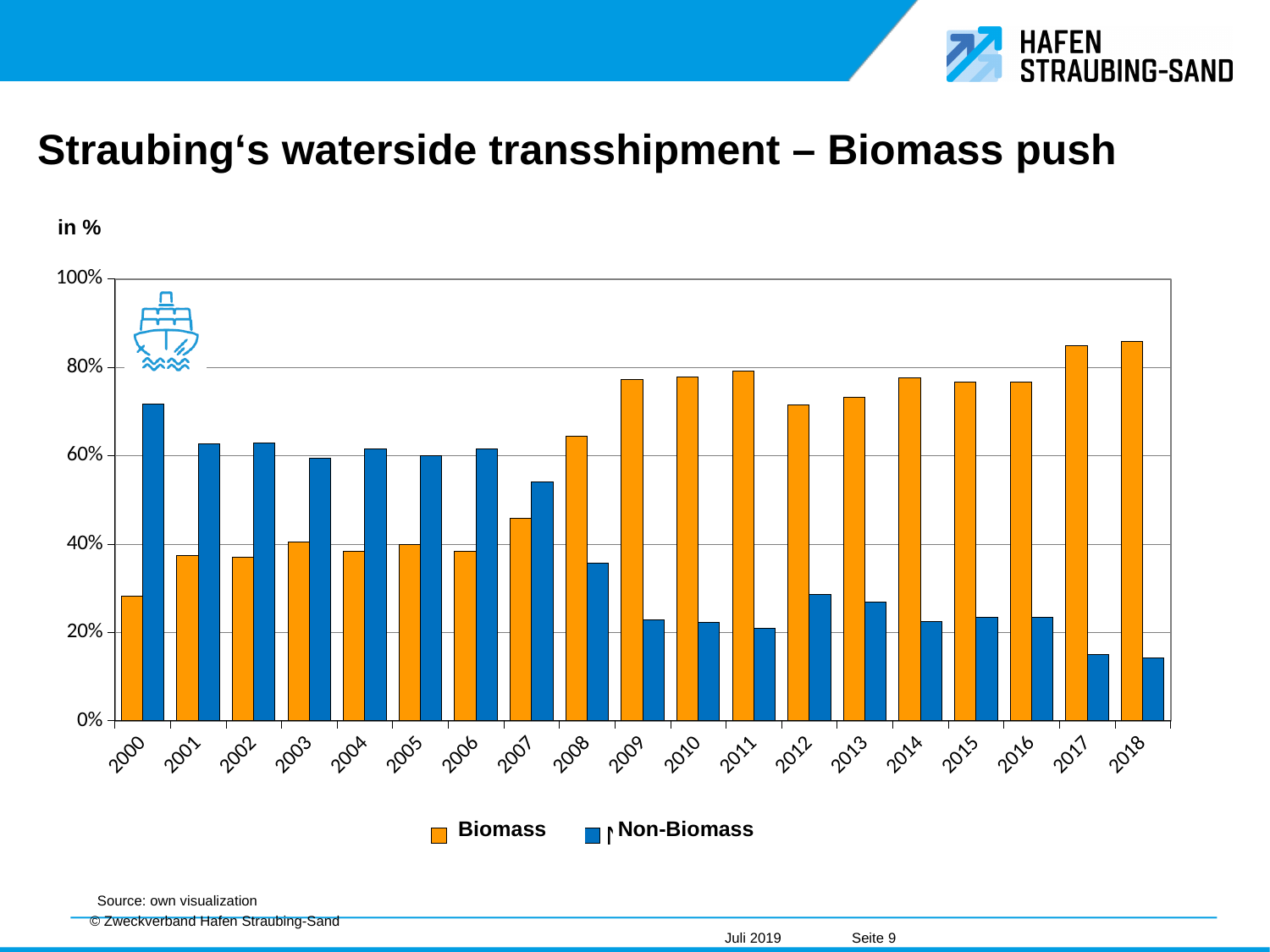
Is the Biomass value for 2000 greater or less than 40%? less How many series does the legend list? 2 How many years are shown on the x axis? 19 Is the Non-Biomass value for 2000 greater or less than 60%? greater In 2008, which is larger, Biomass or Non-Biomass? Biomass In 2007, which is larger, Biomass or Non-Biomass? Non-Biomass In which year is the Biomass share lowest? 2000 In which year is the Non-Biomass share highest? 2000 Is the Non-Biomass value for 2018 greater or less than 20%? less Does the Biomass share generally rise or fall from 2000 to 2018? rise What kind of chart is shown on the slide? bar chart